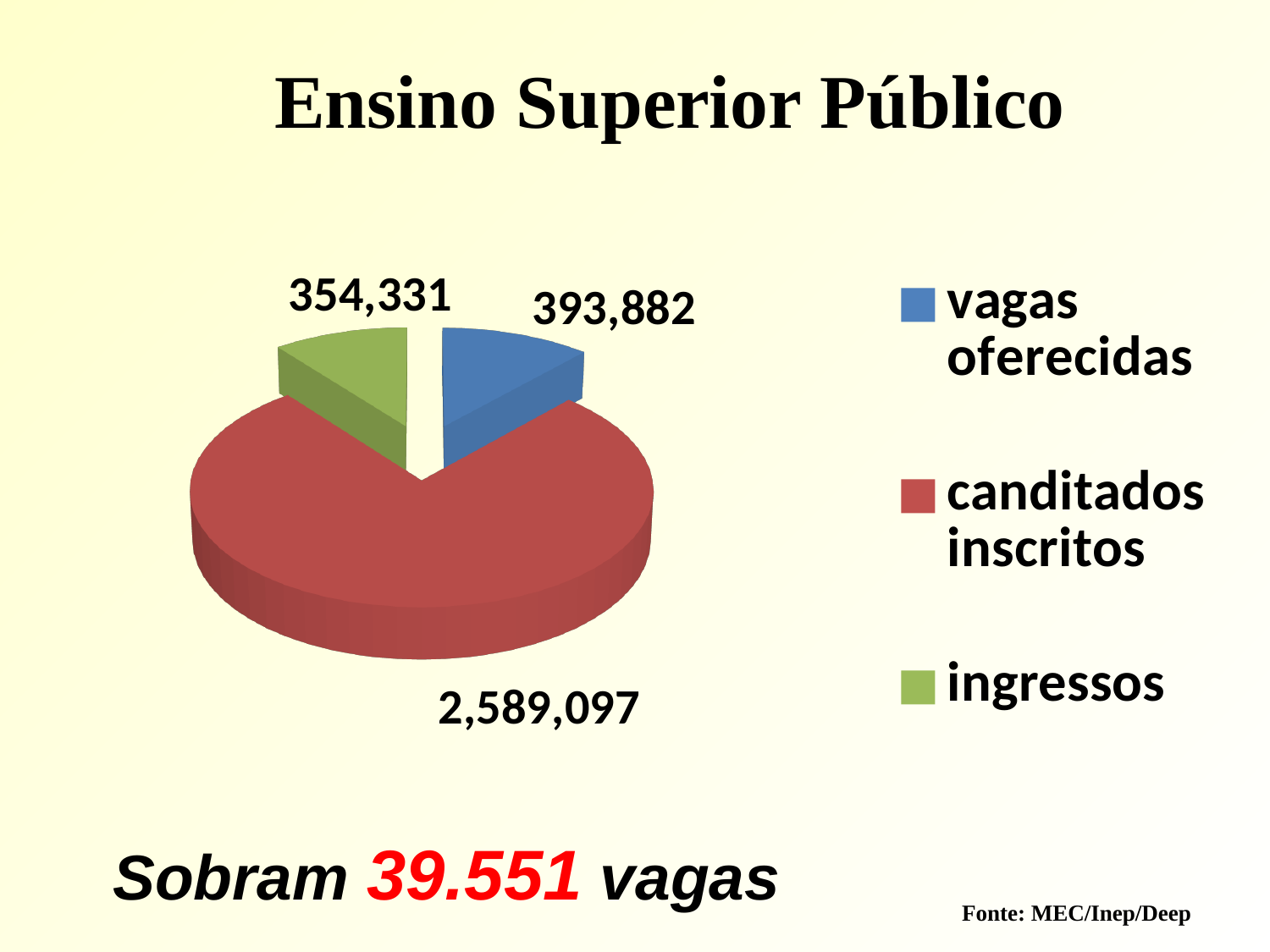
Which is larger, vagas oferecidas or ingressos? vagas oferecidas What is the value for ingressos? 354,331 What is the title of the slide containing the chart? Ensino Superior Público What is the difference between canditados inscritos and vagas oferecidas? 2,195,215 How many slices does the pie chart have? 3 Which colour represents canditados inscritos in the pie chart? Red What is the value for canditados inscritos? 2,589,097 What type of chart is shown on the slide? Pie chart What is the difference between vagas oferecidas and ingressos? 39,551 Which category has the smallest slice of the pie? ingressos Which category has the largest slice of the pie? canditados inscritos What is the value for vagas oferecidas? 393,882